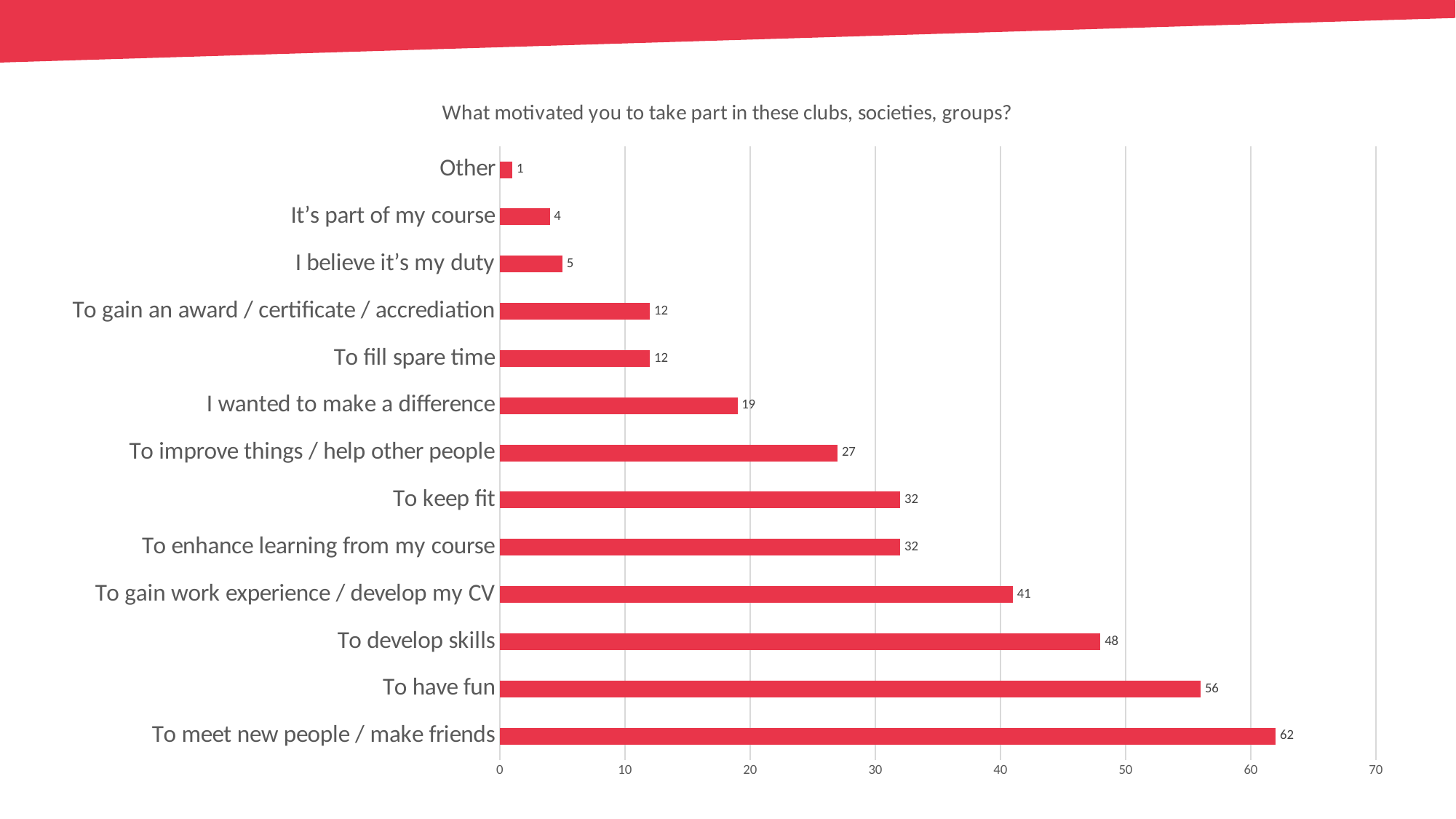
What is the difference between the values for "To have fun" and "It's part of my course"? 52 What is the value for "To gain work experience / develop my CV"? 41 Is the value for "To develop skills" greater or less than 40? greater What is the value for "To have fun"? 56 What is the value for "I wanted to make a difference"? 19 What is the title of the chart? What motivated you to take part in these clubs, societies, groups? What kind of chart is shown on the slide? bar chart Which category has the lowest value? Other Which category has the highest value? To meet new people / make friends Which is larger, the value for "To keep fit" or the value for "To improve things / help other people"? To keep fit How many categories are shown in the chart? 13 What is the difference between the values for "To meet new people / make friends" and "To develop skills"? 14